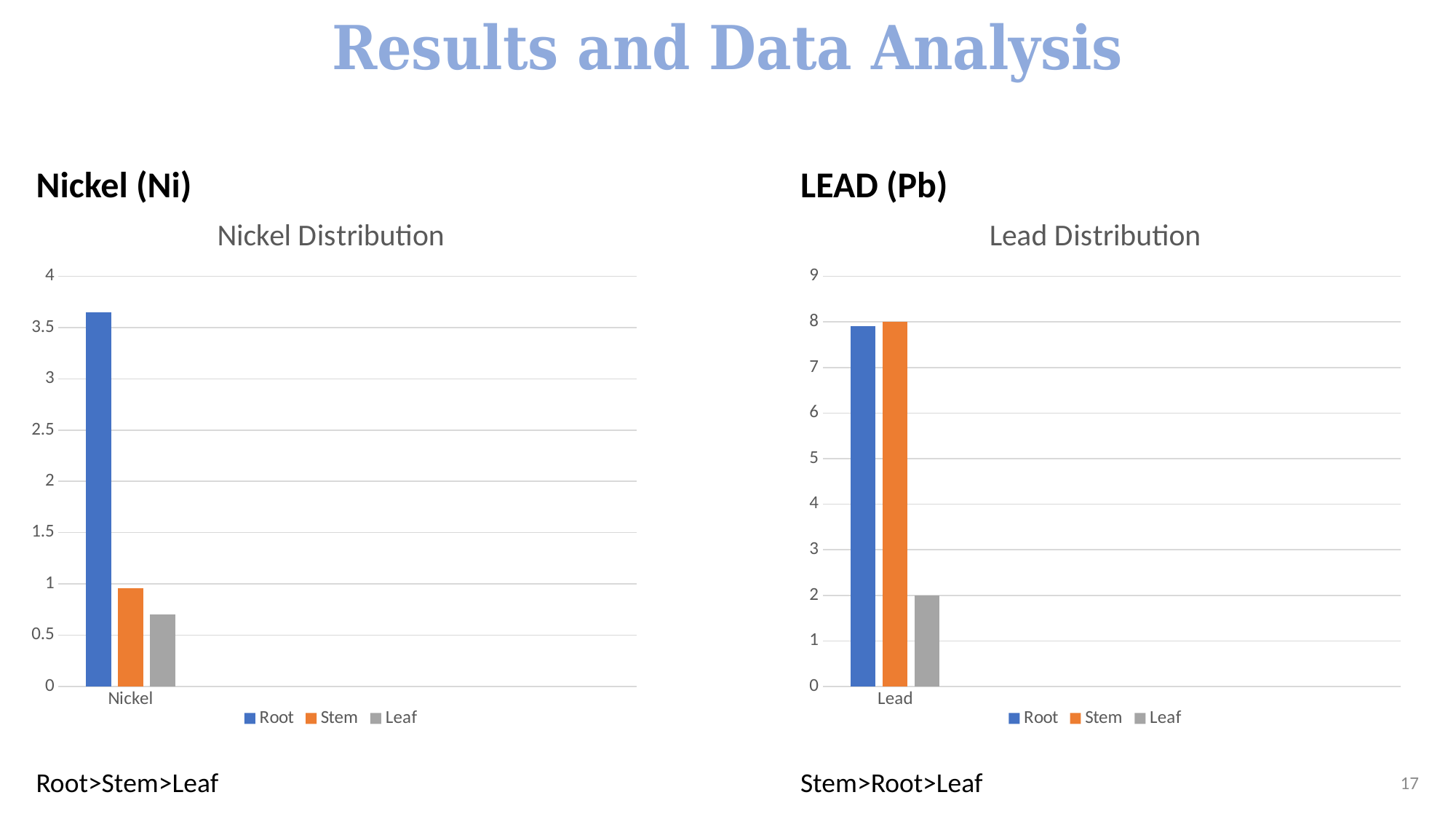
In the Nickel Distribution chart, which series has the highest value? Root In the Nickel Distribution chart, which is larger, Stem or Leaf? Stem What type of chart is the Nickel Distribution chart? bar chart In the Nickel Distribution chart, is the value for Root greater or less than 3.5? greater In the Nickel Distribution chart, which series has the lowest value? Leaf In the Lead Distribution chart, which series has the lowest value? Leaf In the Lead Distribution chart, is the value for Root greater or less than 7? greater What is the title of the chart on the right side of the slide? Lead Distribution In the Lead Distribution chart, what is the value for Leaf? 2 In the Nickel Distribution chart, is the value for Leaf greater or less than 0.5? greater How many series does the legend of the Lead Distribution chart list? 3